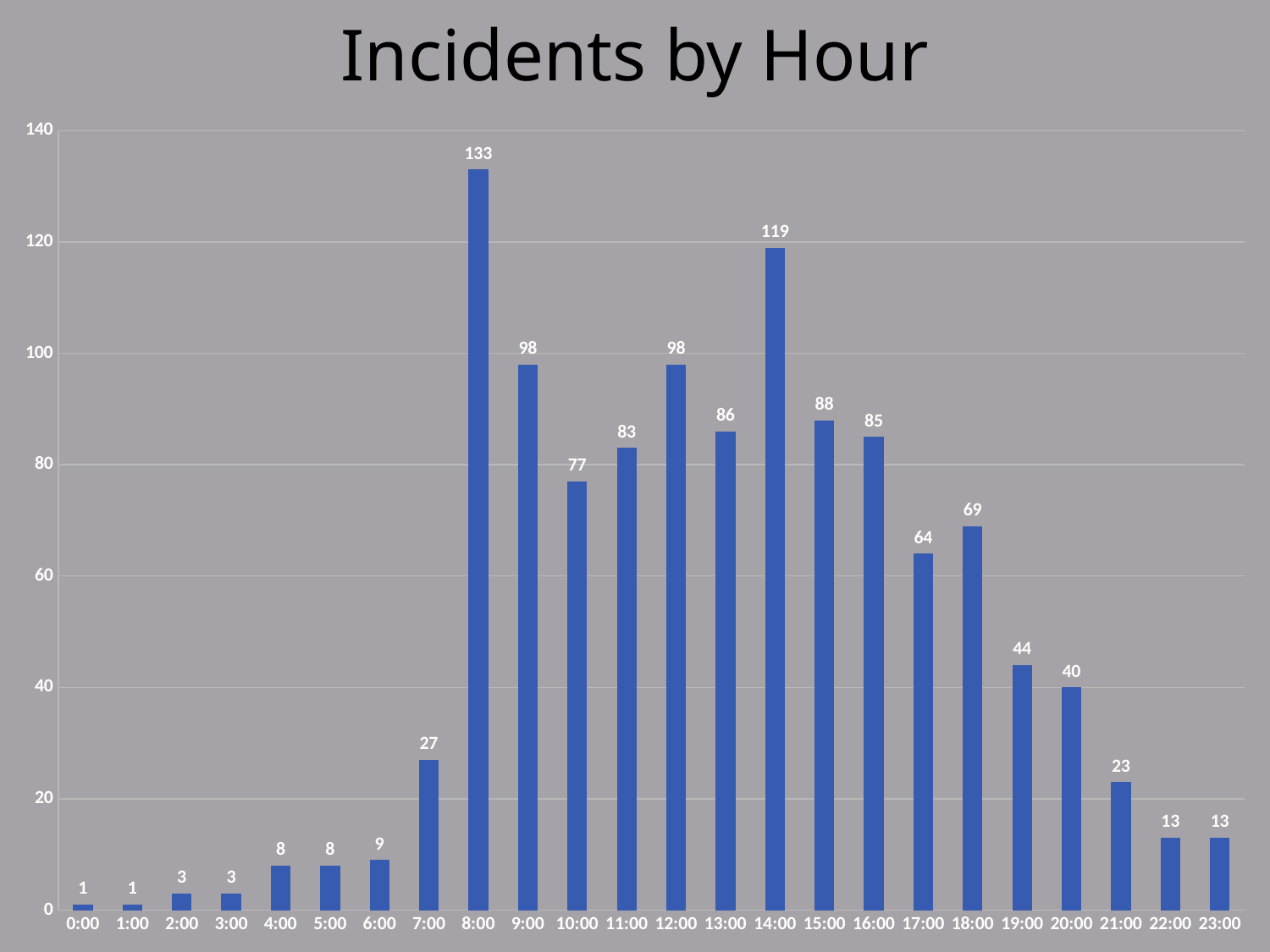
What is the difference between the values for 8:00 and 14:00? 14 What is the difference between the values for 9:00 and 10:00? 21 What is the value for 14:00? 119 What kind of chart is this? Bar chart Do the values rise or fall from 14:00 to 23:00? Fall What is the value for 17:00? 64 Which hour has the highest number of incidents? 8:00 How many hours (categories) are shown on the x axis? 24 Is the value for 18:00 greater or less than 60? greater What is the title of the chart? Incidents by Hour Which is larger, the value for 15:00 or the value for 16:00? 15:00 What is the value for 8:00? 133